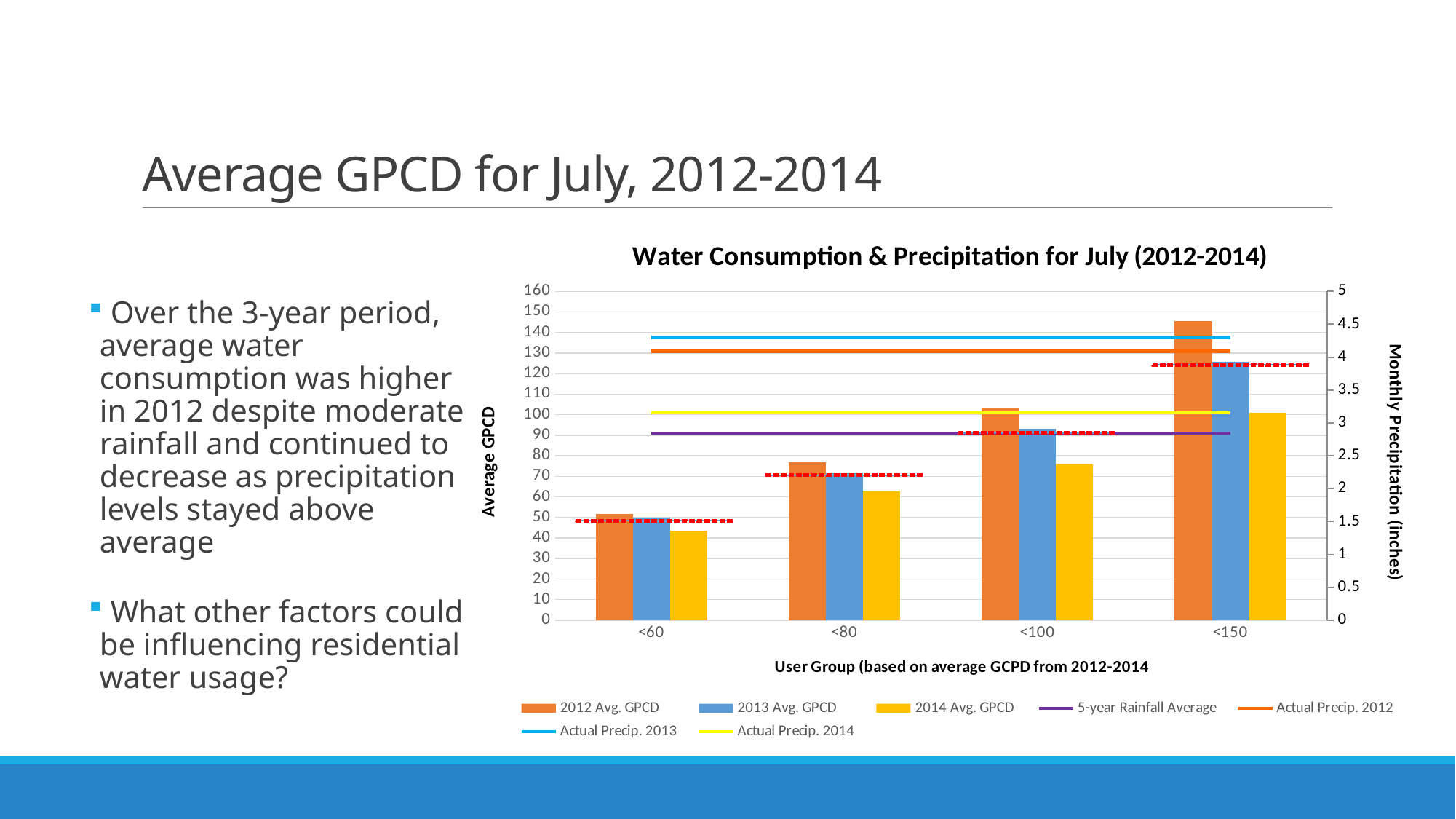
Is the 2013 Avg. GPCD value for the <80 user group greater or less than 80? less Is the 2014 Avg. GPCD value for the <60 user group greater or less than 50? less How many user group categories are shown on the x axis of the chart? 4 Is the 2012 Avg. GPCD value for the <150 user group greater or less than 140? greater How many series does the chart's legend list? 7 For the <150 user group, which is larger: the 2012 Avg. GPCD or the 2014 Avg. GPCD? 2012 Avg. GPCD Which user group has the highest 2012 Avg. GPCD bar? <150 Do the 2012 Avg. GPCD bars rise or fall moving from the <60 group to the <150 group? rise What is the label of the secondary (right-hand) y axis of the chart? Monthly Precipitation (inches) Which user group has the lowest 2014 Avg. GPCD bar? <60 What kind of chart is used to show the Avg. GPCD values in the 'Water Consumption & Precipitation for July (2012-2014)' chart? bar chart